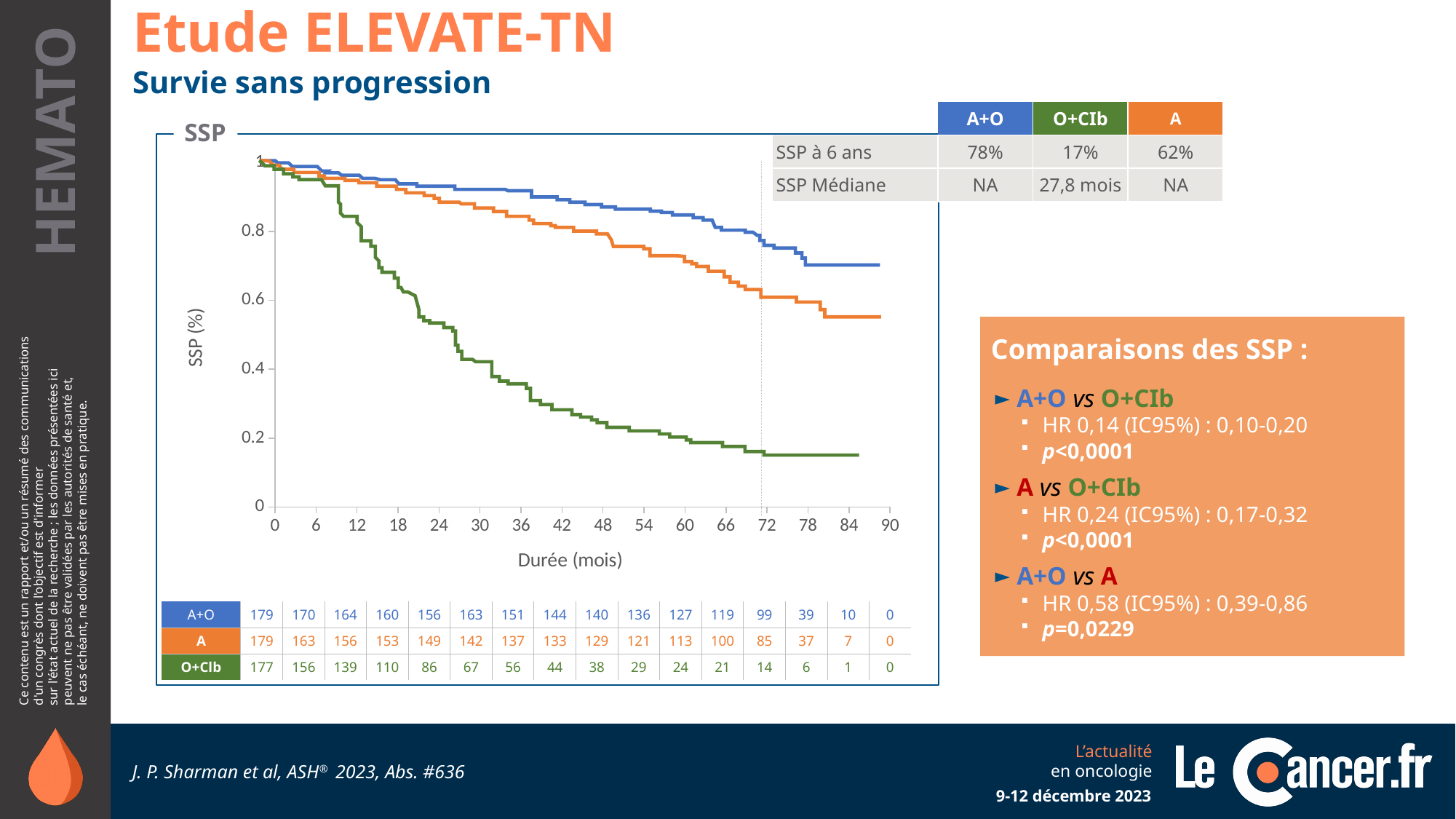
Which arm has the lowest SSP à 6 ans? O+CIb Is the value of the A+O curve at 48 months greater or less than 0.8? greater What is the label of the x axis of the SSP chart? Durée (mois) According to the table, what is the SSP à 6 ans for the A+O arm? 78% What is the SSP Médiane reported for the O+CIb arm? 27,8 mois How many series (treatment arms) are plotted on the SSP chart? 3 What is the difference in SSP à 6 ans between the A+O arm (78%) and the A arm (62%)? 16 percentage points Which arm has the highest SSP à 6 ans? A+O According to the table, what is the SSP à 6 ans for the O+CIb arm? 17% Is the value of the O+CIb curve at 48 months greater or less than 0.4? less What kind of chart is shown on the slide? line chart (Kaplan-Meier survival curves) At 60 months, which curve is higher, A+O or O+CIb? A+O